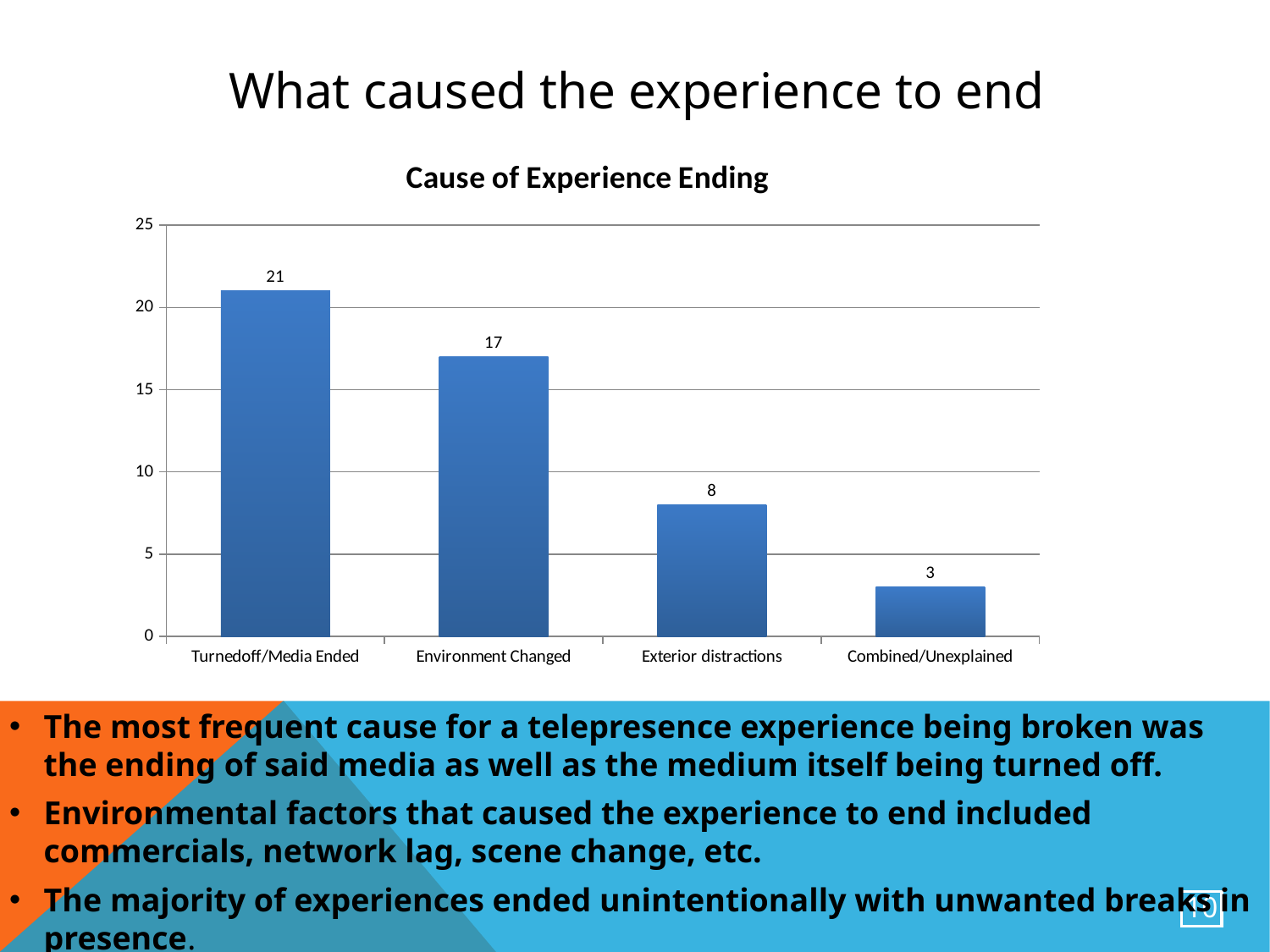
Which category has the lowest value? Combined/Unexplained What is the value for Combined/Unexplained? 3 What is the value for Environment Changed? 17 Which category has the highest value? Turnedoff/Media Ended Which is larger, the value for Exterior distractions or the value for Combined/Unexplained? Exterior distractions What is the value for Exterior distractions? 8 What is the difference between the values for Turnedoff/Media Ended and Environment Changed? 4 What is the title of the chart? Cause of Experience Ending Is the value for Environment Changed greater or less than 15? greater What is the value for Turnedoff/Media Ended? 21 How many categories are shown on the x axis? 4 What kind of chart is shown? bar chart